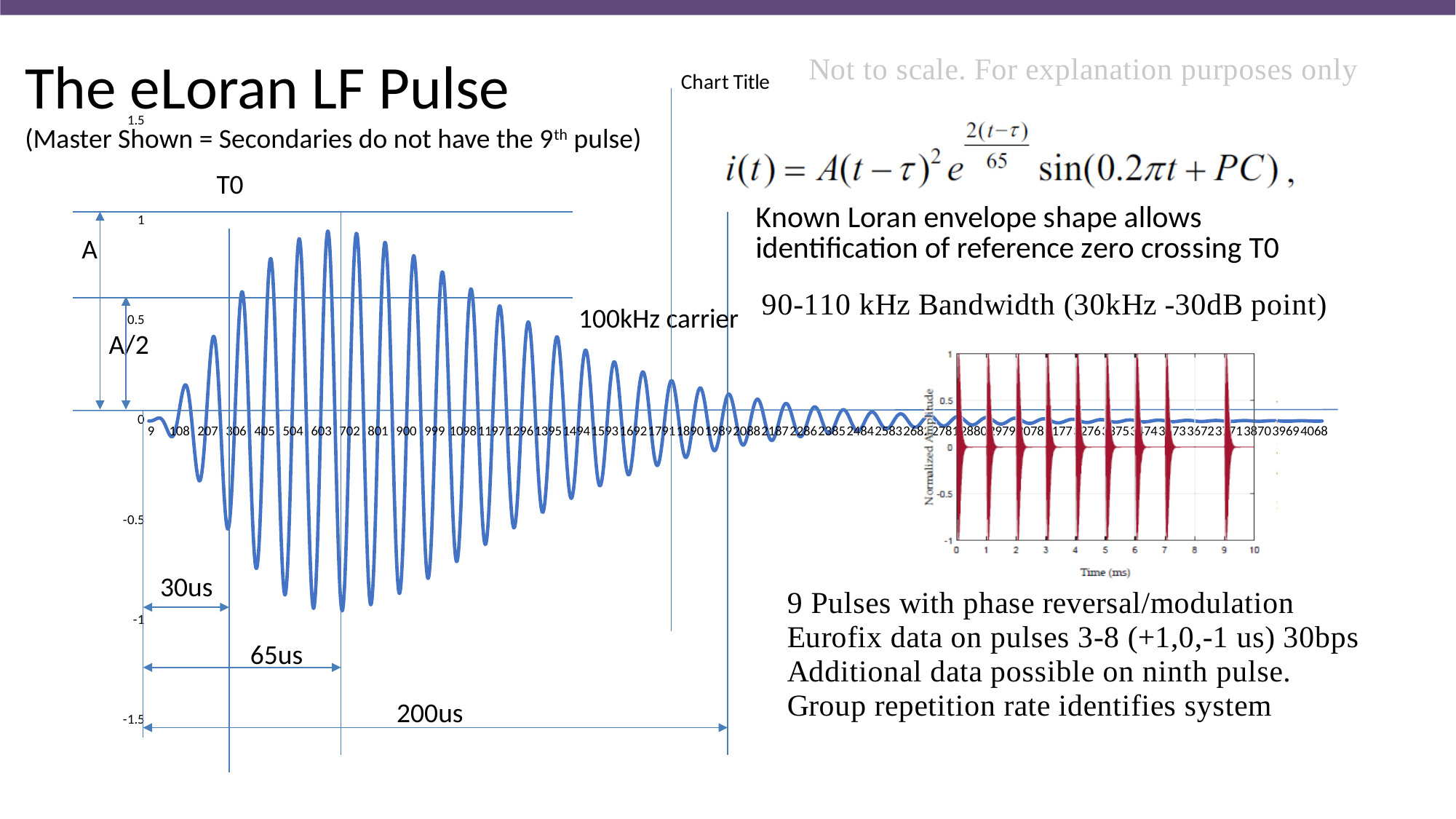
What is the title printed above the line chart? Chart Title What colour is the waveform line in the line chart? blue Is the highest peak of the waveform in the line chart greater or less than 1.5? less Is the deepest trough of the waveform in the line chart greater or less than -0.5? less What is the highest tick value shown on the vertical axis of the line chart? 1.5 What is the first label on the horizontal axis of the line chart? 9 What is the lowest tick value shown on the vertical axis of the line chart? -1.5 Is the value of the waveform at the last x-axis label (4068) greater or less than 0.5? less After reaching its peak, does the amplitude of the oscillation in the line chart grow or decay as you move right along the x axis? decay What is the last label on the horizontal axis of the line chart? 4068 What kind of chart is shown on the left of the slide? line chart